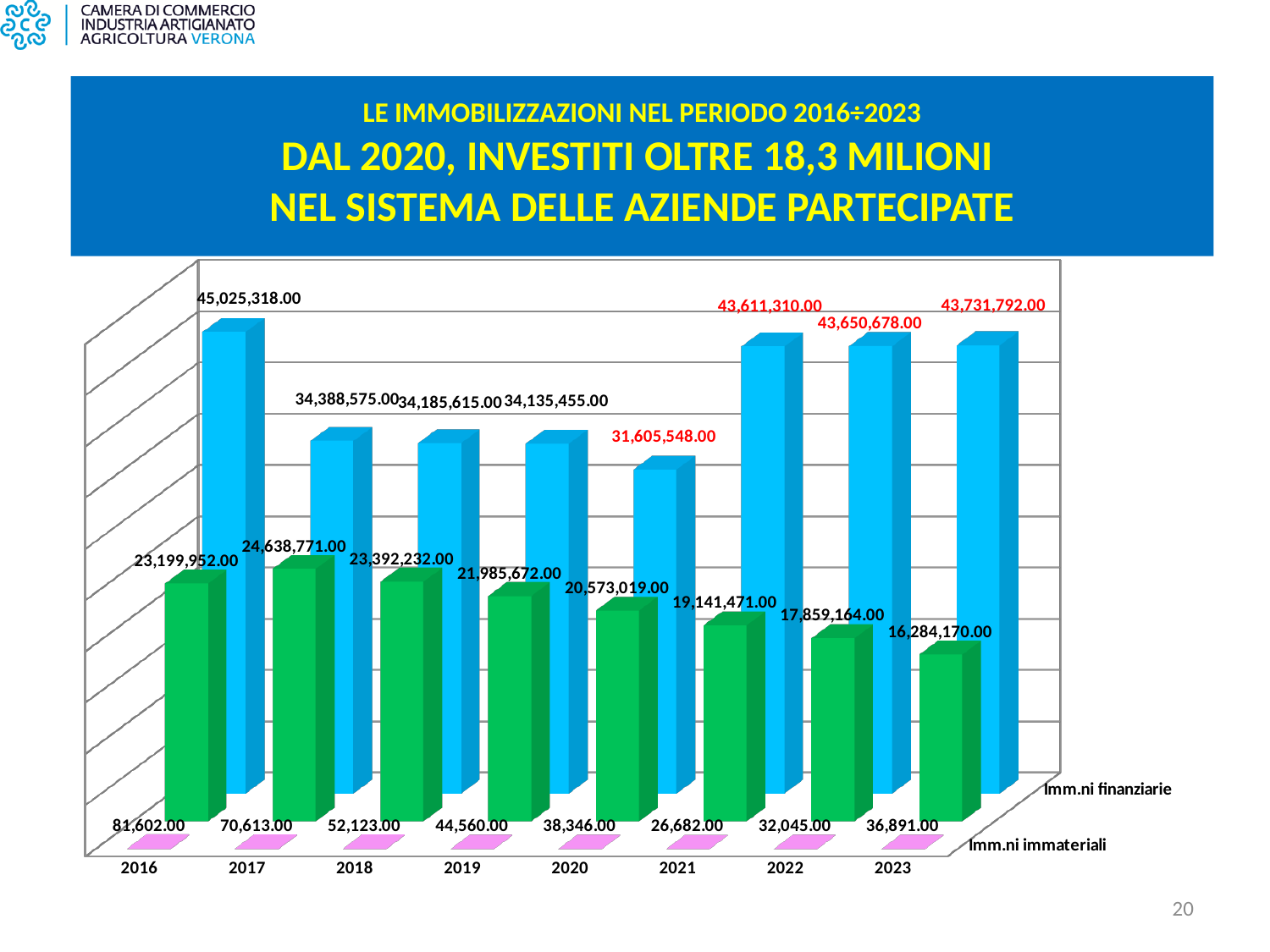
What is the difference between Imm.ni immateriali in 2016 and in 2023? 44,711.00 What is the value of Imm.ni finanziarie in 2020? 31,605,548.00 Which is larger, Imm.ni finanziarie in 2017 or in 2021? 2021 What is the value of Imm.ni finanziarie in 2016? 45,025,318.00 What kind of chart is shown on the slide? Bar chart In which year is Imm.ni immateriali lowest? 2021 How many years are shown on the x axis? 8 What is the value of Imm.ni immateriali in 2021? 26,682.00 In which year is the green series highest? 2017 What is the difference between Imm.ni finanziarie in 2023 and in 2020? 12,126,244.00 In which year is Imm.ni finanziarie lowest? 2020 In which year is Imm.ni finanziarie highest? 2016